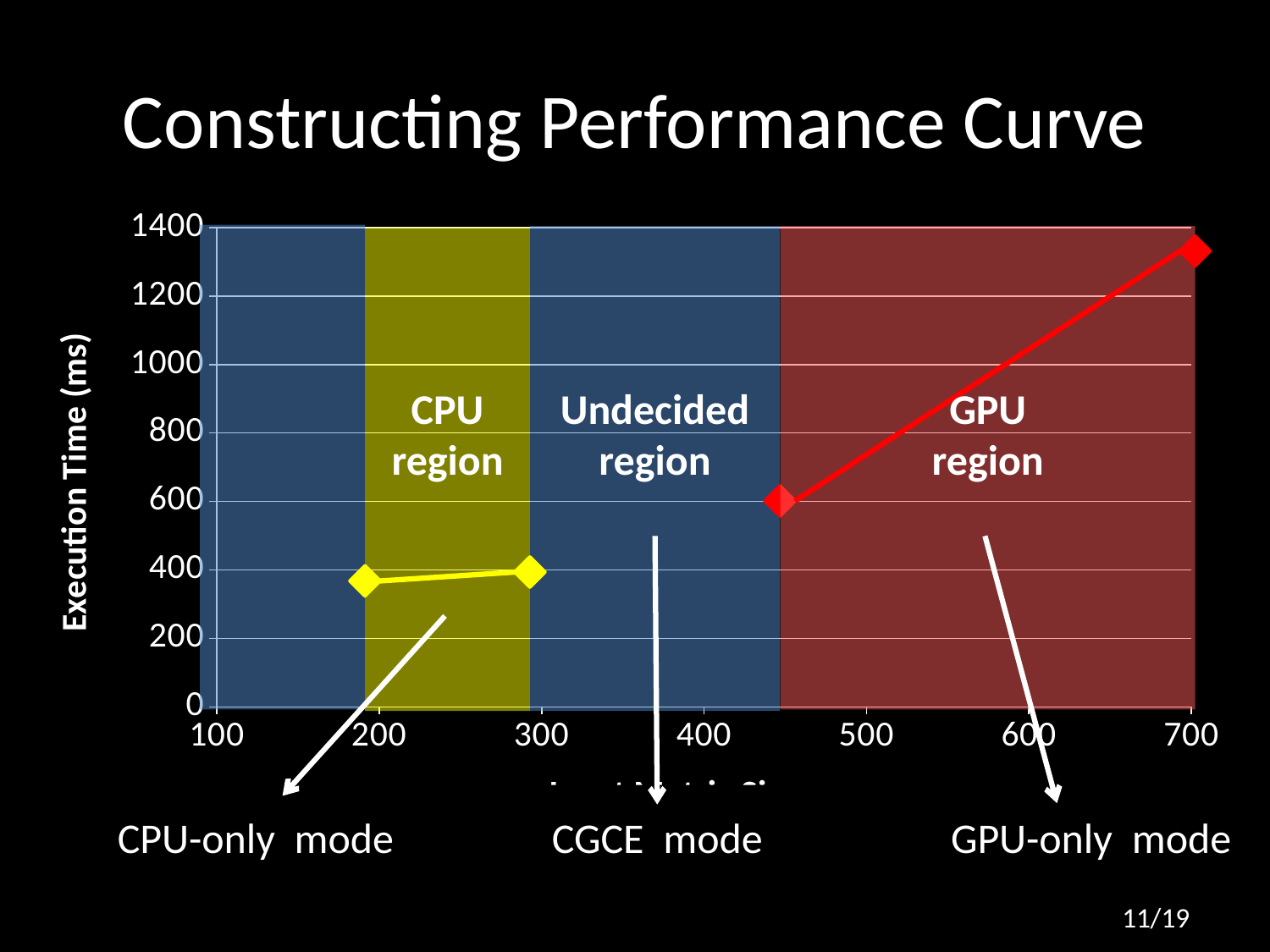
Does the red line rise or fall as the input size increases along the x axis? rises Is the execution time of the left red point (near x = 450) greater or less than 400? greater What is the title of the slide containing the chart? Constructing Performance Curve Which region on the chart has the highest execution times: the CPU region, the Undecided region, or the GPU region? GPU region What is the label of the y axis? Execution Time (ms) Is the execution time of the rightmost red point (near x = 700) greater or less than 1200? greater Is the execution time of the leftmost yellow point (near x = 200) greater or less than 600? less What kind of chart is shown on the slide? line chart Which mode is associated with the Undecided region according to the annotation below the chart? CGCE mode Which plotted point has the highest execution time: the red point near x = 700 or the yellow point near x = 300? the red point near x = 700 How many data points are plotted on the chart in total? 4